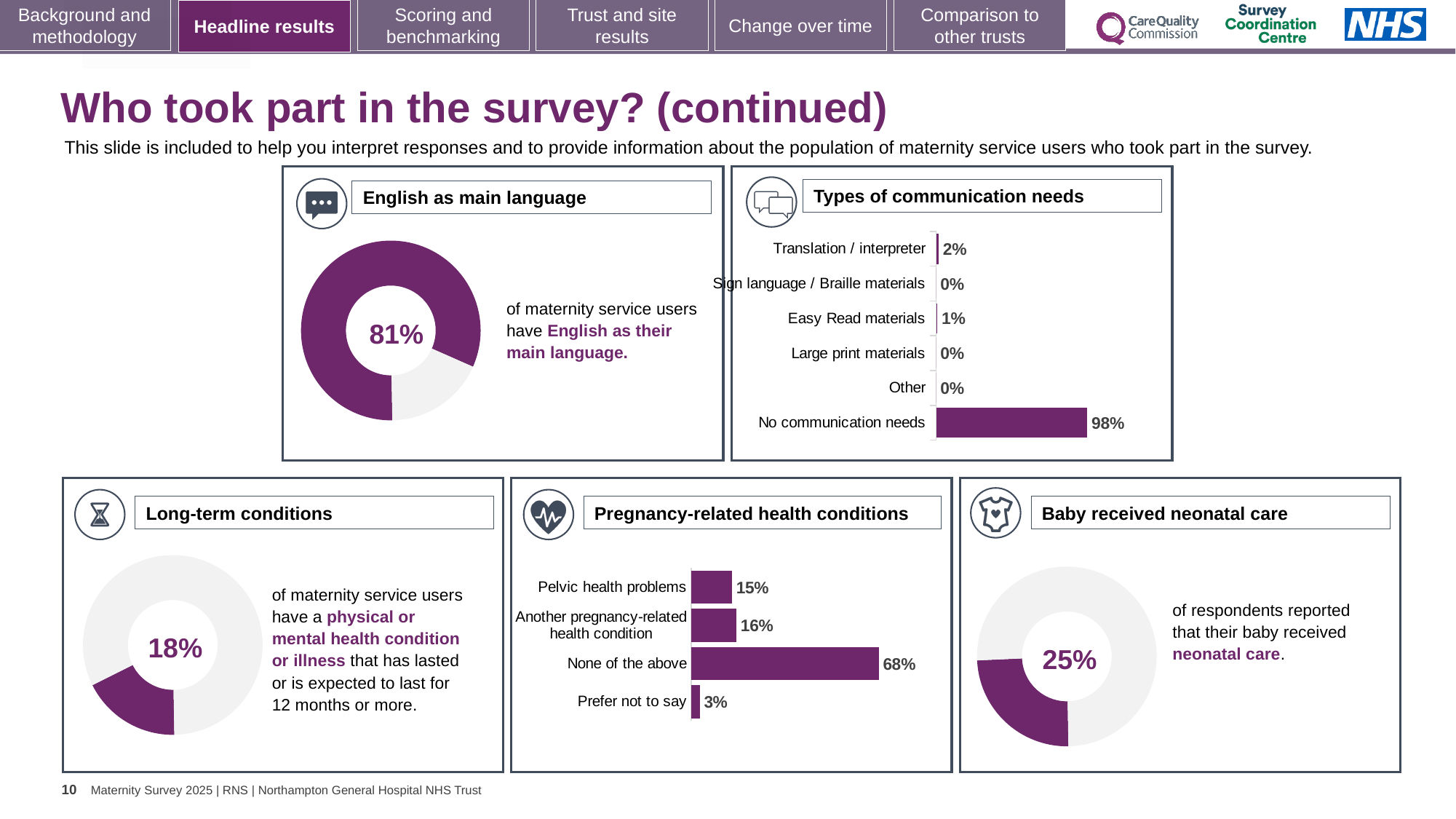
In the 'Pregnancy-related health conditions' chart, what is the difference between 'None of the above' and 'Another pregnancy-related health condition'? 52% In the 'Pregnancy-related health conditions' chart, which category has the lowest value? Prefer not to say How many categories are shown in the 'Types of communication needs' chart? 6 In the 'Types of communication needs' chart, what percentage is shown for 'Translation / interpreter'? 2% In the 'English as main language' chart, what percentage of maternity service users have English as their main language? 81% In the 'Pregnancy-related health conditions' chart, what percentage is shown for 'Pelvic health problems'? 15% What kind of chart is used in the 'Pregnancy-related health conditions' panel? Bar chart In the 'Types of communication needs' chart, which category has the highest value? No communication needs In the 'Types of communication needs' chart, what percentage is shown for 'No communication needs'? 98% In the 'Baby received neonatal care' chart, what percentage of respondents reported that their baby received neonatal care? 25% In the 'Pregnancy-related health conditions' chart, which is larger: 'Pelvic health problems' or 'Another pregnancy-related health condition'? Another pregnancy-related health condition In the 'Long-term conditions' chart, what percentage of maternity service users have a physical or mental health condition or illness lasting 12 months or more? 18%